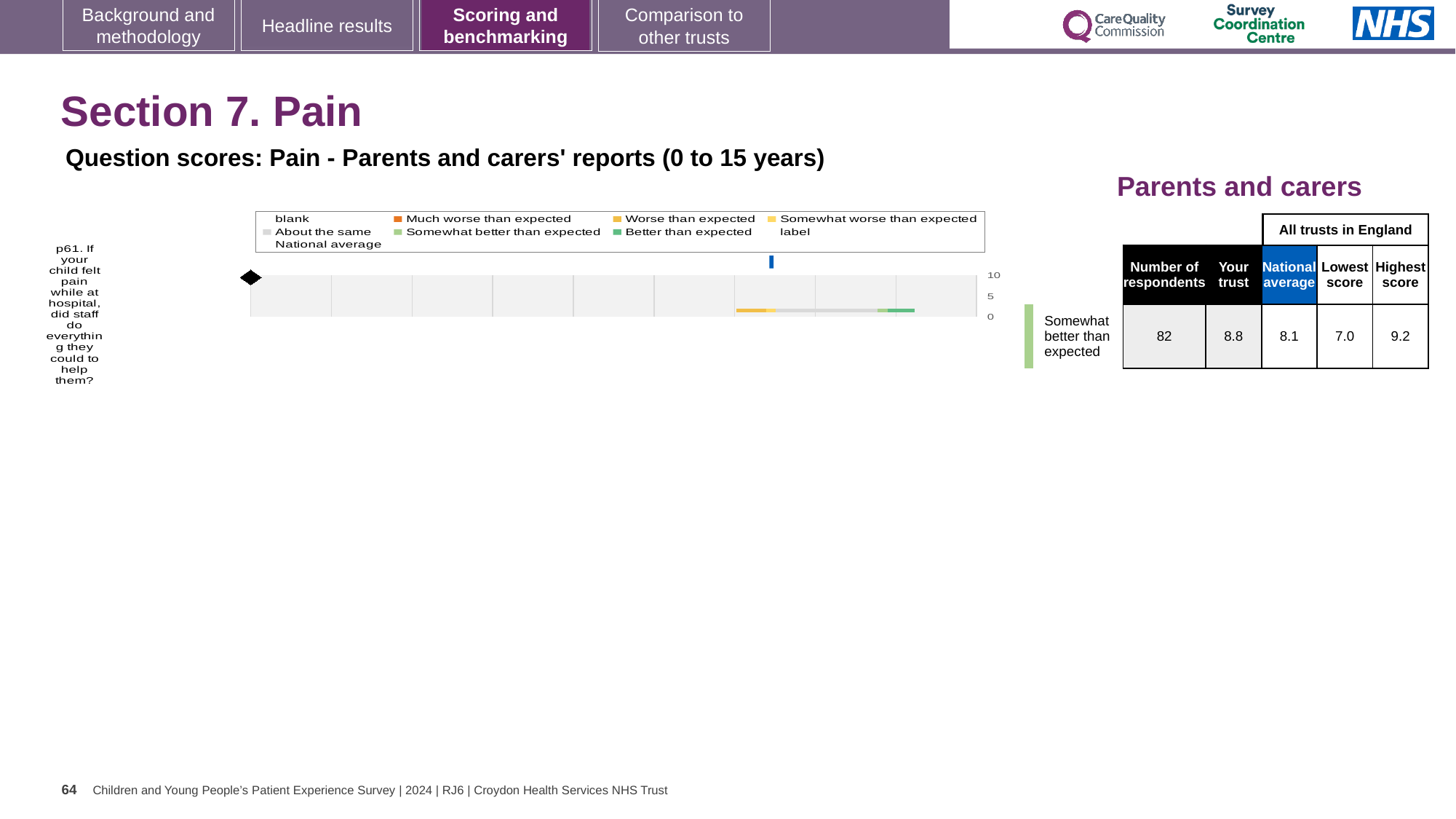
According to the table for question p61, what is the score for Your trust? 8.8 Which legend entry in the chart is shown in orange? Much worse than expected For question p61, which is larger: the Your trust score or the National average score? Your trust For question p61, what is the difference between the Your trust score and the National average score? 0.7 For question p61, what is the difference between the Highest score and the Lowest score among all trusts in England? 2.2 How many respondents answered question p61 according to the table? 82 According to the table for question p61, what is the Lowest score among all trusts in England? 7.0 According to the table for question p61, what is the National average score? 8.1 According to the table for question p61, what is the Highest score among all trusts in England? 9.2 How many survey questions are plotted in the chart on this slide? 1 What kind of chart is shown on the slide for question p61? bar chart Which question is plotted in the chart on this slide? p61. If your child felt pain while at hospital, did staff do everything they could to help them?